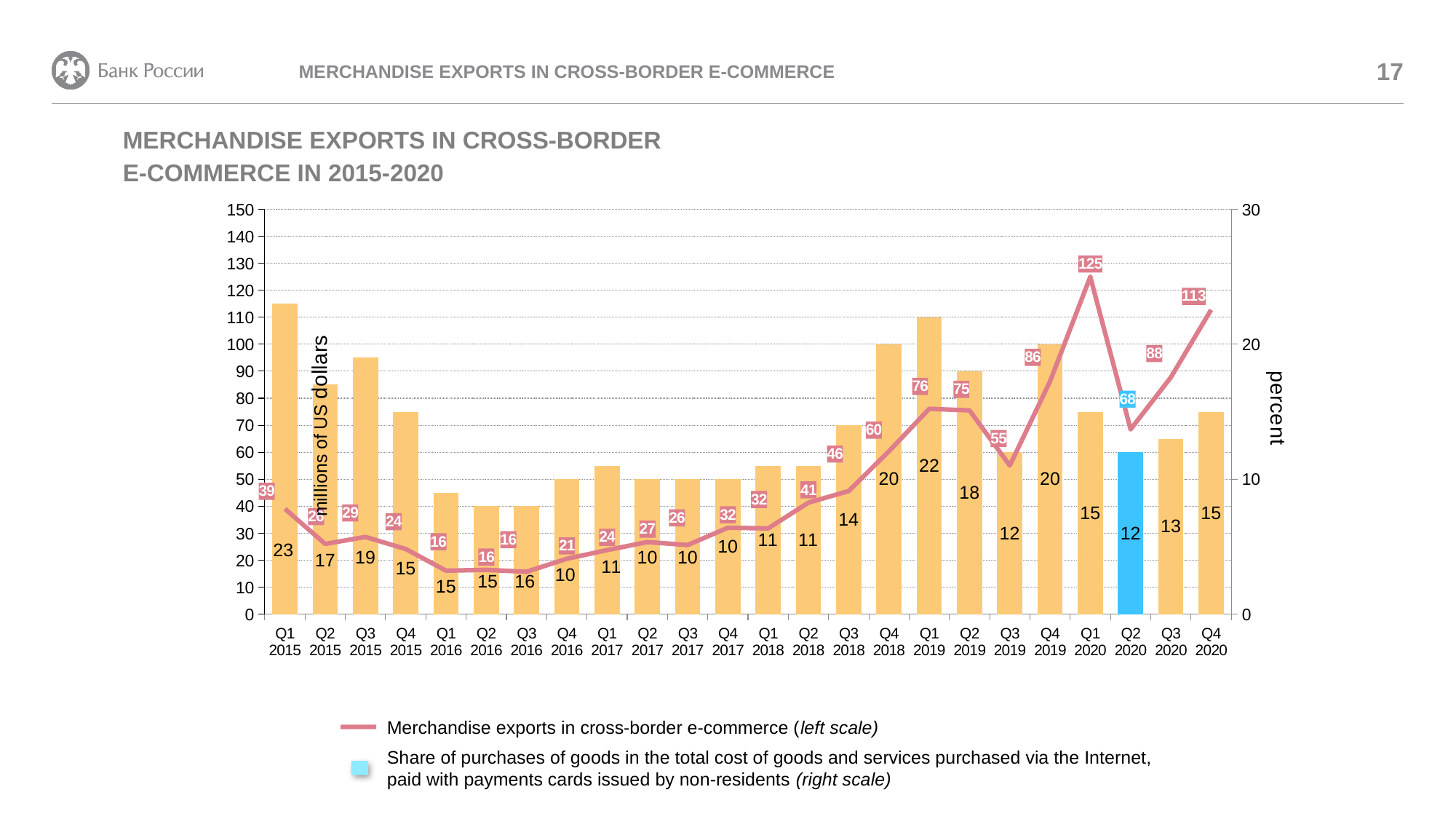
What is the value of merchandise exports in cross-border e-commerce in Q1 2020? 125 How many quarters are shown on the x axis of the chart? 24 What is the share of purchases of goods in the total cost of goods and services purchased via the Internet in Q1 2019? 22 How many series does the legend list? 2 What kind of chart is shown on the slide? Combined bar and line chart Which quarter has higher merchandise exports in cross-border e-commerce, Q3 2020 or Q4 2020? Q4 2020 What is the difference between merchandise exports in Q1 2020 and Q2 2020? 57 What is the value of merchandise exports in cross-border e-commerce in Q4 2020? 113 What is the share of purchases of goods (right scale) in Q2 2020, the highlighted blue bar? 12 In which quarter is the share of purchases of goods (bars) highest? Q1 2015 In which quarter is merchandise exports in cross-border e-commerce highest? Q1 2020 What is the difference between the share of purchases of goods in Q1 2019 and Q3 2019? 10